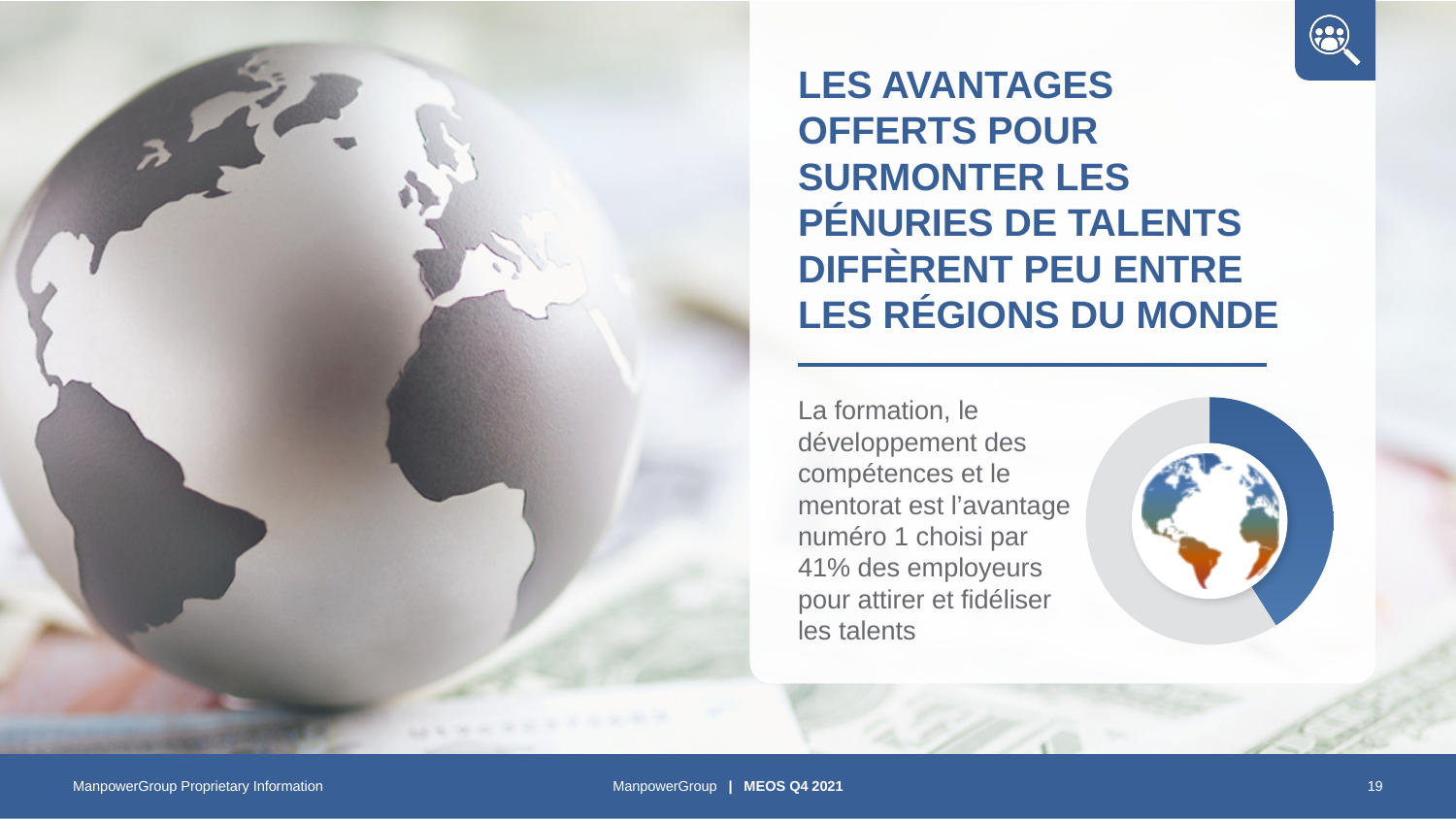
What kind of chart is shown on the right side of the slide? doughnut chart Is the blue segment of the doughnut chart greater or less than half of the ring? less Which segment of the doughnut chart is larger, the blue one or the grey one? the grey one How many segments does the doughnut chart have? 2 What colour is the segment of the doughnut chart that represents the employers who chose training, skills development and mentoring? blue What share of employers does the blue segment of the doughnut chart represent? 41% What image is shown in the centre of the doughnut chart? a globe